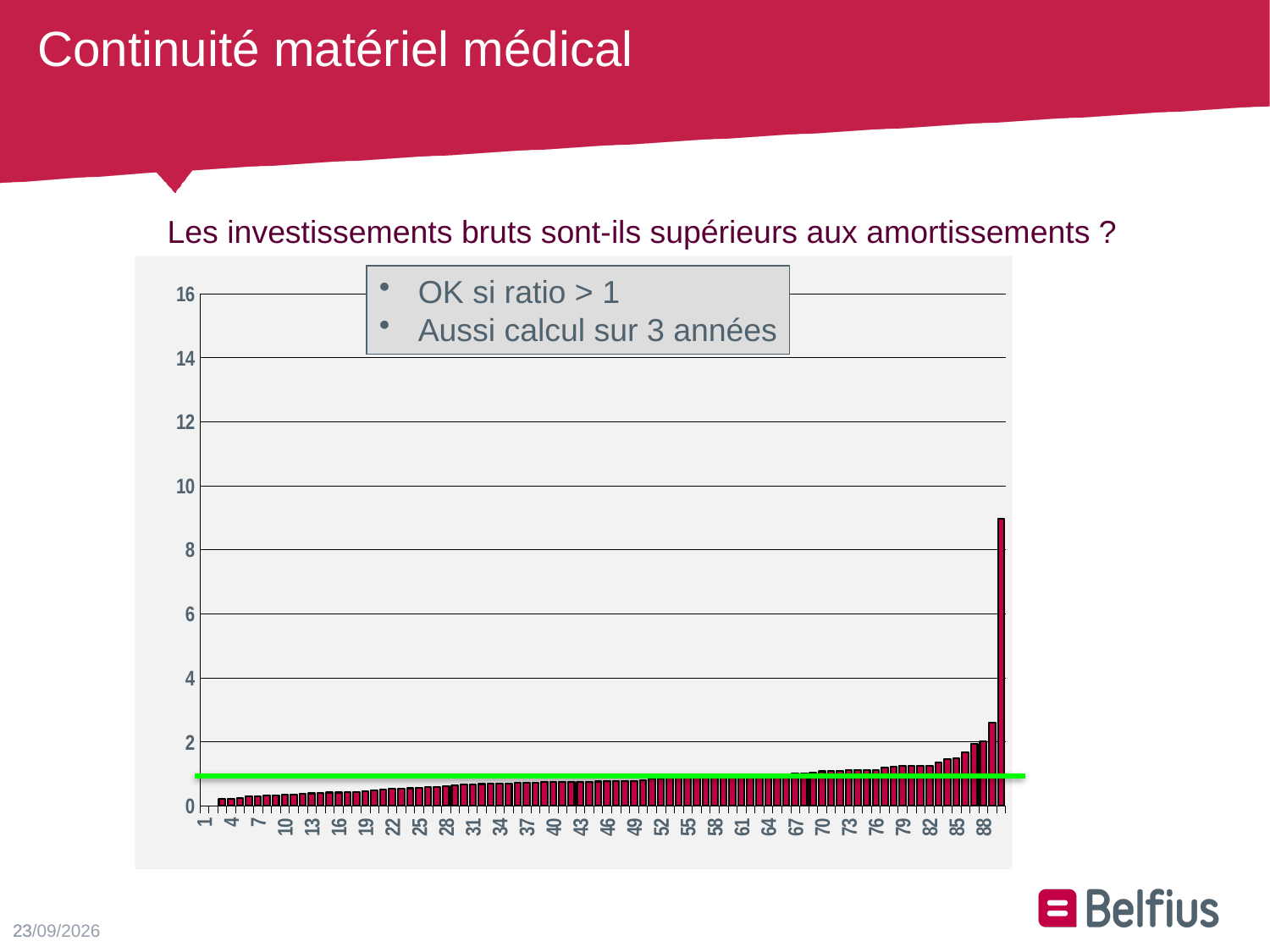
Is the value of the tallest bar greater or less than 10? less At what y-axis value is the green horizontal line drawn? 1 Is the value of the tallest bar greater or less than 8? greater What kind of chart is shown on the slide? bar chart Is the value for category 1 greater or less than 2? less Do the bar values rise or fall from left to right along the x axis? rise What is the highest value shown on the y axis? 16